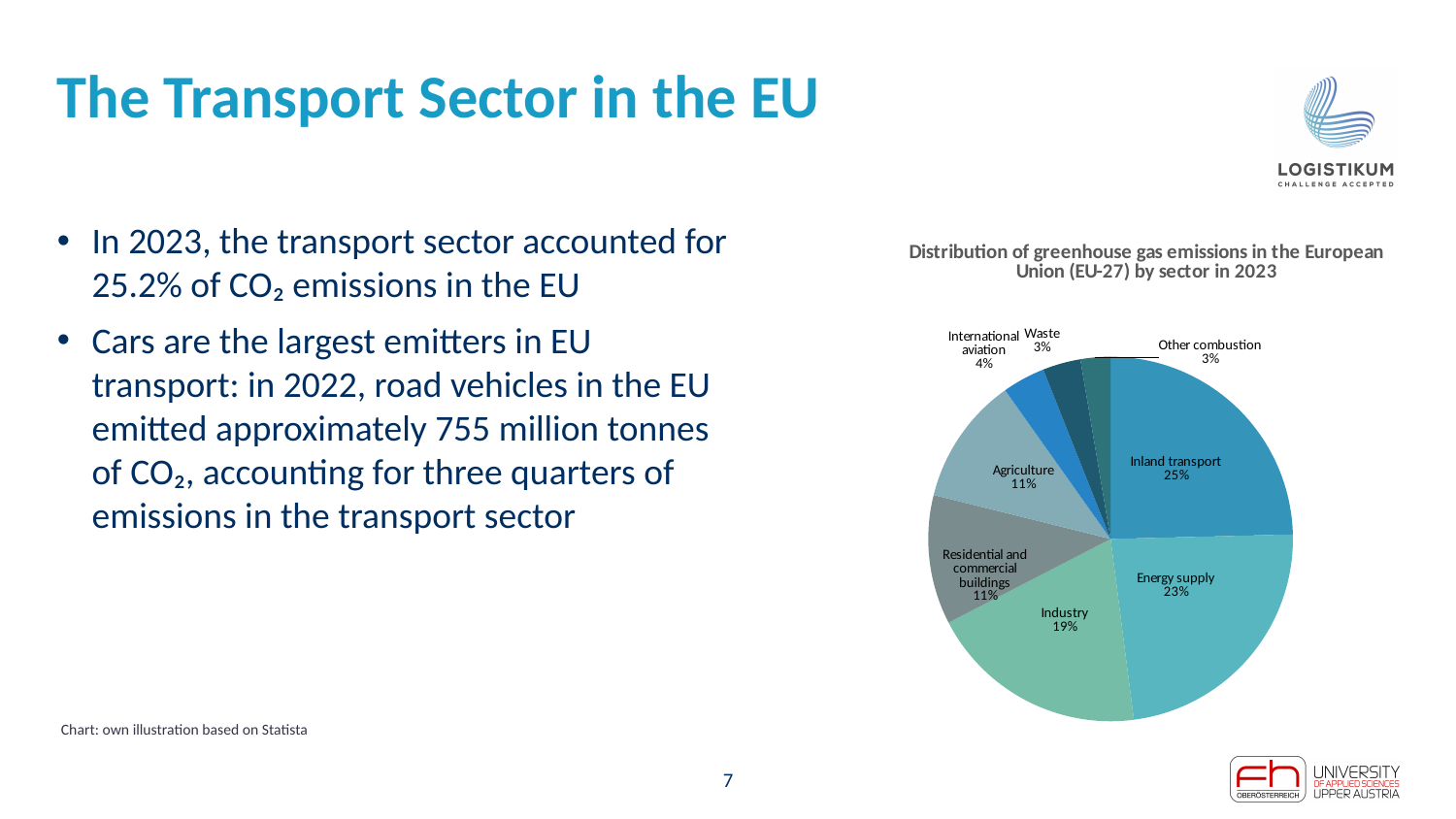
How many sectors (slices) are shown in the pie chart? 8 What type of chart is shown on the slide? Pie chart Which has a larger share in the pie chart, Industry or Agriculture? Industry What share of greenhouse gas emissions does Inland transport account for in the pie chart? 25% What is the title of the chart? Distribution of greenhouse gas emissions in the European Union (EU-27) by sector in 2023 What is the difference in percentage points between Industry and Residential and commercial buildings? 8 percentage points What is the difference in percentage points between Inland transport and Energy supply? 2 percentage points Which sector has the largest slice in the pie chart? Inland transport What percentage is shown for Energy supply in the pie chart? 23% What percentage is shown for International aviation in the pie chart? 4% What percentage is shown for Agriculture in the pie chart? 11% What percentage is shown for Industry in the pie chart? 19%